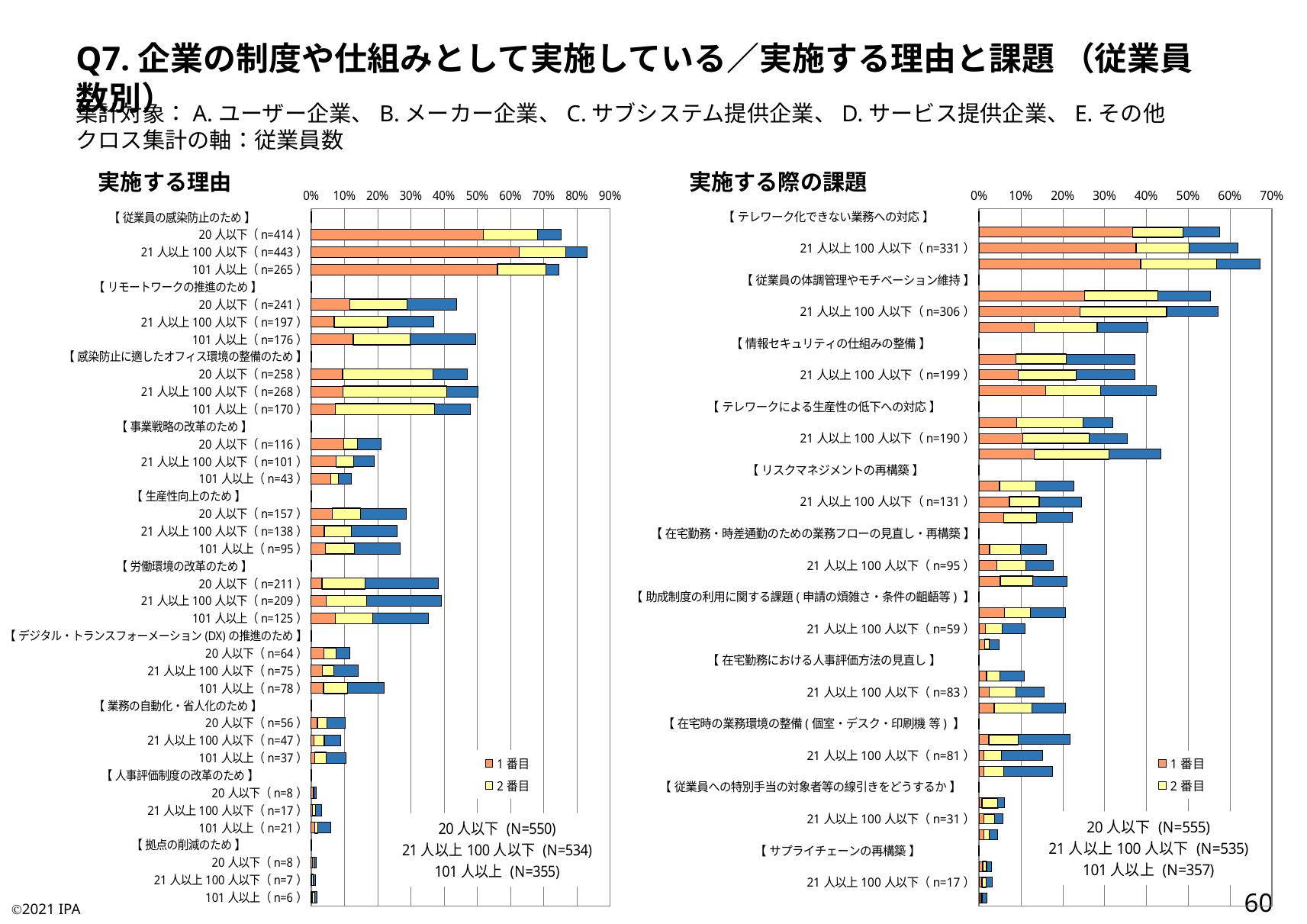
In the left chart (実施する理由), which total bar is longer for 20人以下: 従業員の感染防止のため or 事業戦略の改革のため? 従業員の感染防止のため In the left chart (実施する理由), is the total bar for 従業員の感染防止のため, 20人以下 (n=414) greater or less than 70%? greater What is the title of the chart on the right side of the slide? 実施する際の課題 In the right chart (実施する際の課題), is the total bar for 情報セキュリティの仕組みの整備, 21人以上100人以下 (n=199) greater or less than 40%? less In the left chart (実施する理由), is the total bar for 従業員の感染防止のため, 21人以上100人以下 (n=443) greater or less than 80%? greater How many series does the legend of the right chart (実施する際の課題) list? 2 What kind of chart is the left chart titled 実施する理由? bar chart In the right chart (実施する際の課題), which item has the longest bars? テレワーク化できない業務への対応 In the left chart (実施する理由), which bar is the longest overall? 従業員の感染防止のため, 21人以上100人以下 (n=443)